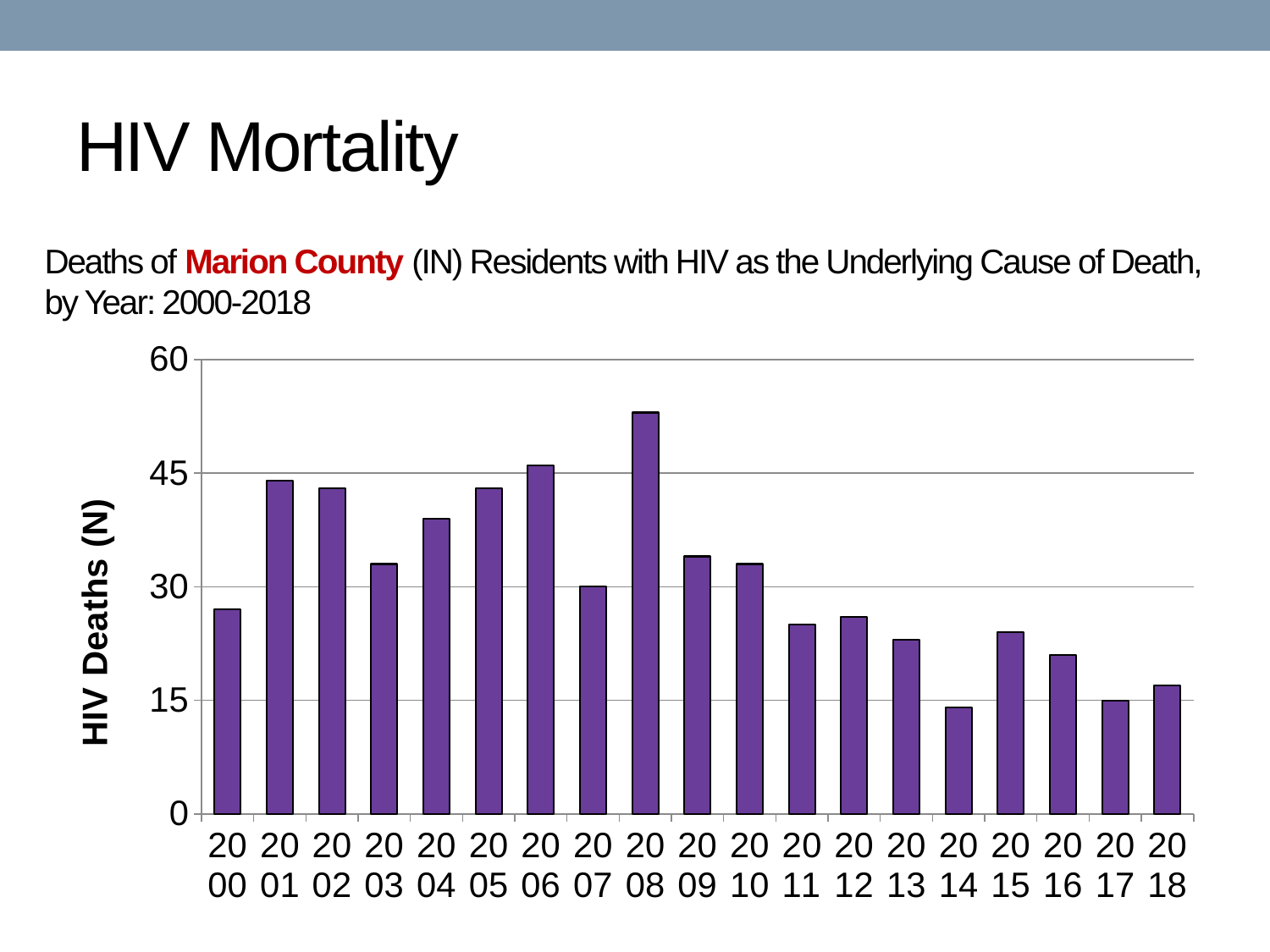
Which year has the highest number of HIV deaths? 2008 Is the value for 2000 greater or less than 30? less What kind of chart is shown on the slide? bar chart Is the value for 2008 greater or less than 45? greater What is the label on the y axis? HIV Deaths (N) Which is larger, the value for 2001 or the value for 2003? 2001 How many years are plotted on the x axis? 19 Which year has the lowest number of HIV deaths? 2014 Do HIV deaths generally rise or fall from 2008 to 2018? fall Is the value for 2011 greater or less than 30? less